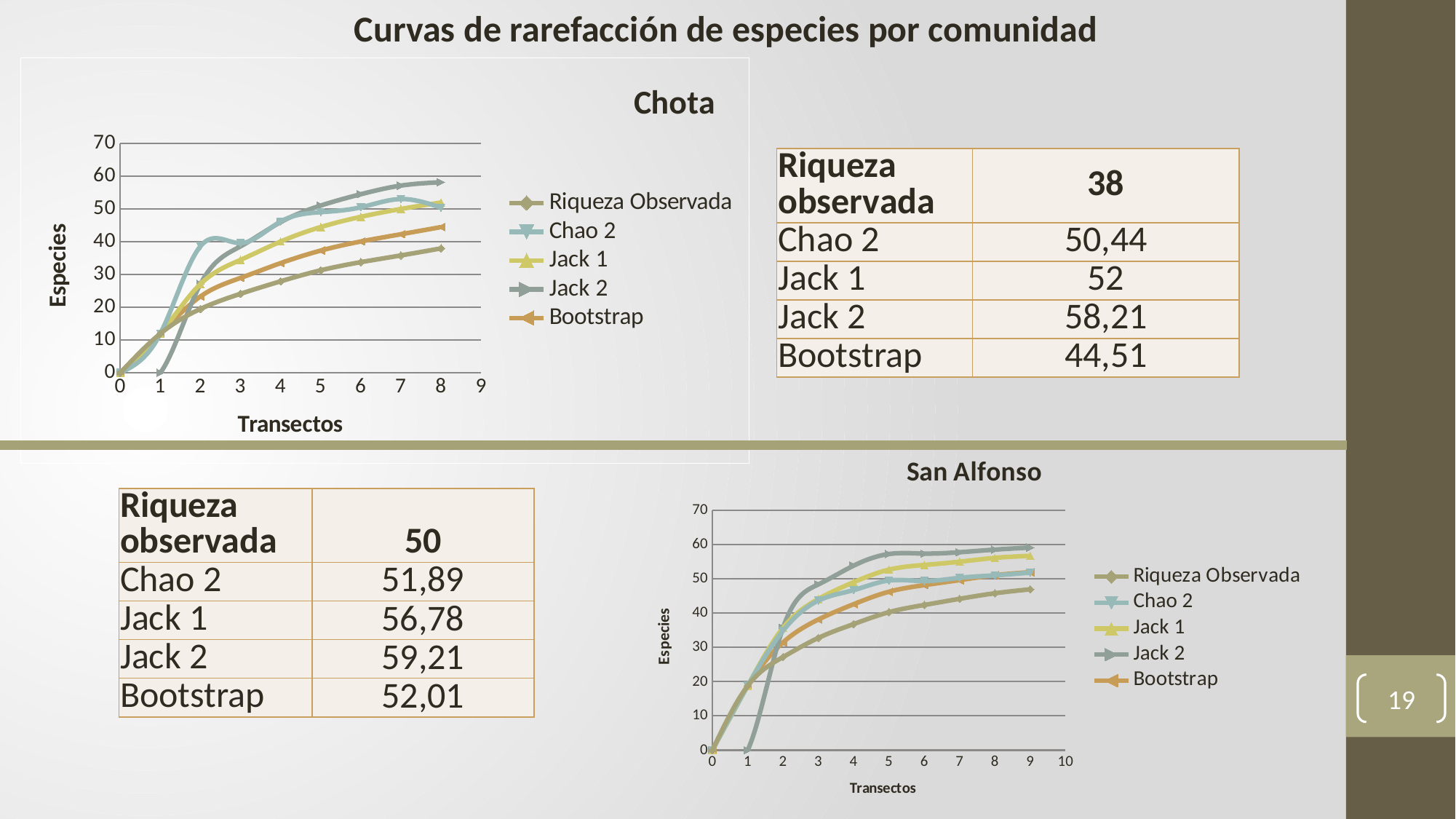
In the San Alfonso chart, which series has the highest value at transect 9? Jack 2 In the Chota chart, at transect 8, which is larger: Jack 1 or Bootstrap? Jack 1 In the San Alfonso chart, which series has the lowest value at transect 9? Riqueza Observada How many series does the legend of the San Alfonso chart list? 5 In the Chota chart, which series has the lowest value at transect 8? Riqueza Observada In the San Alfonso chart, do the values of Riqueza Observada rise or fall as the number of transects increases? rise What kind of chart is the Chota chart? line chart In the Chota chart, which series has the highest value at transect 8? Jack 2 What is the label of the vertical axis on the Chota chart? Especies In the San Alfonso chart, how many transect points are plotted for the Riqueza Observada series? 10 In the San Alfonso chart, is the value of Riqueza Observada at transect 9 greater or less than 50? less In the Chota chart, is the value of Jack 2 at transect 8 greater or less than 50? greater